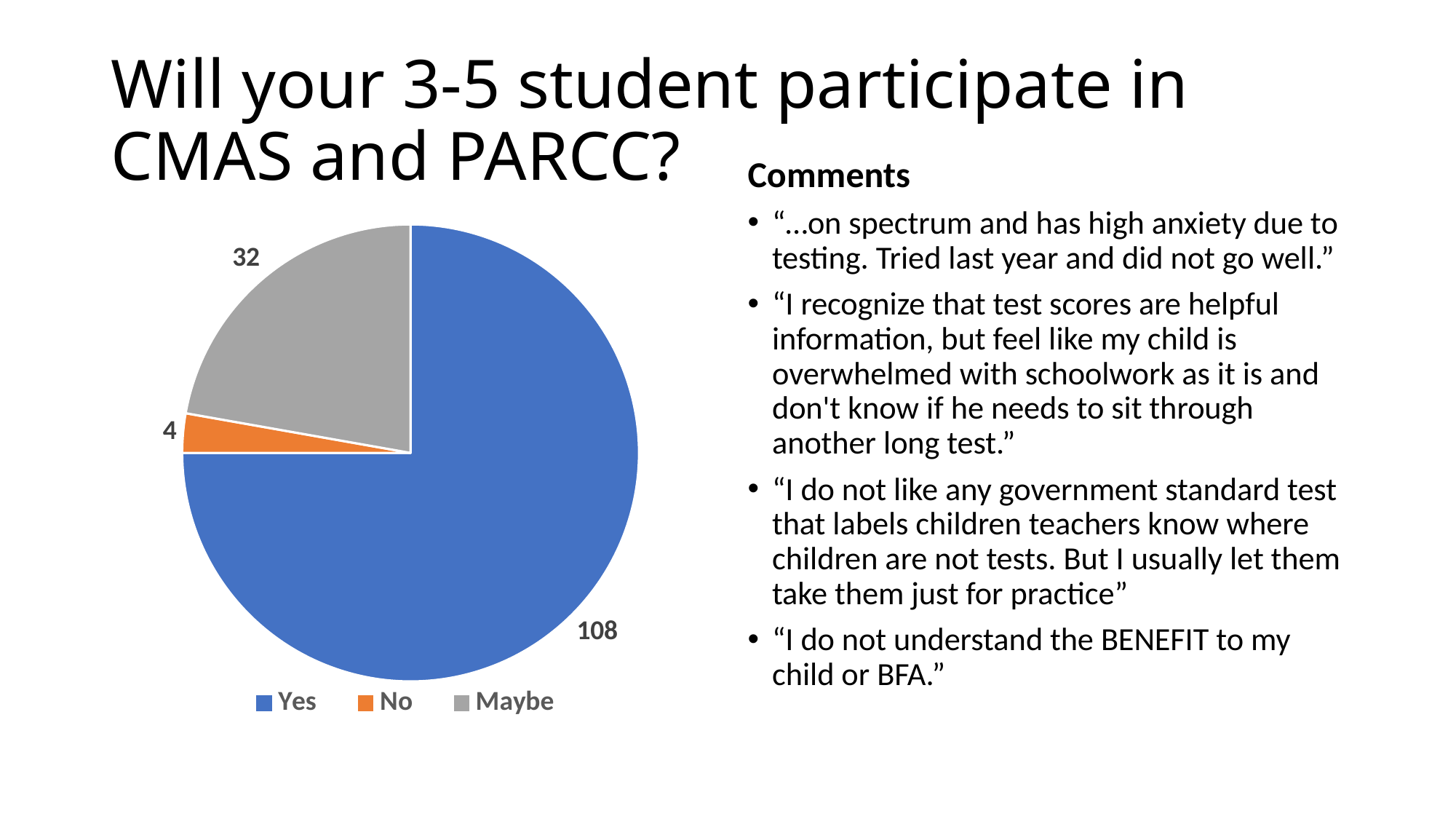
Which colour represents the Maybe slice? gray What is the value for Maybe? 32 What is the value for No? 4 What is the total of all slices in the pie chart? 144 What is the value for Yes? 108 What is the difference between the values for Yes and Maybe? 76 What is the difference between the values for Maybe and No? 28 What kind of chart is shown on the slide? pie chart Which is larger, the value for Maybe or the value for No? Maybe How many categories does the pie chart have? 3 Which category has the lowest value? No Which category has the highest value? Yes